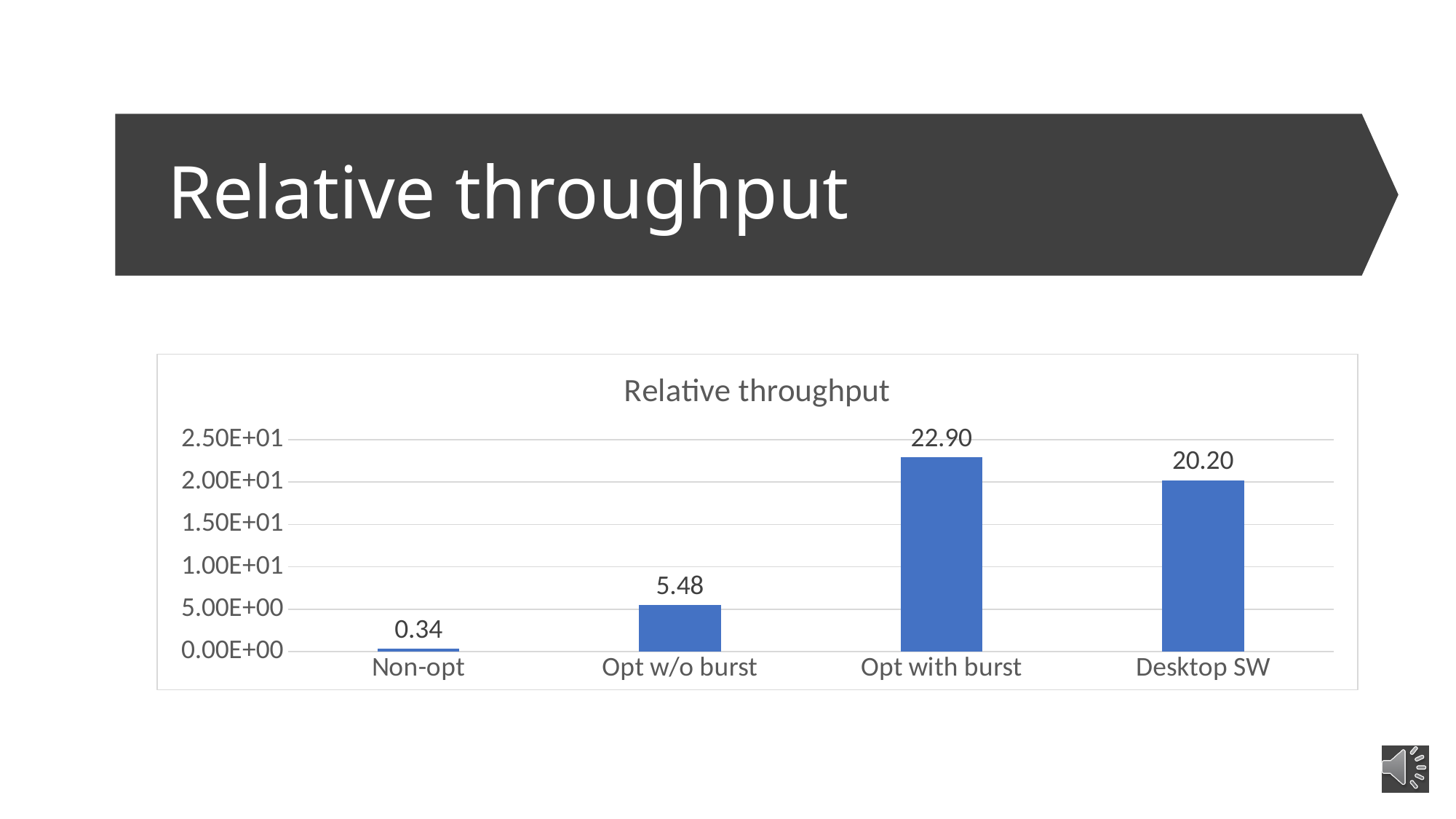
What is the relative throughput value for Non-opt? 0.34 Which category has the highest relative throughput? Opt with burst Which is larger, the value for Opt w/o burst or the value for Desktop SW? Desktop SW What is the relative throughput value for Desktop SW? 20.20 What is the title of the chart? Relative throughput What is the relative throughput value for Opt w/o burst? 5.48 How many categories are shown on the x axis? 4 What is the relative throughput value for Opt with burst? 22.90 What kind of chart is shown on the slide? Bar chart What is the difference between the values for Opt with burst and Desktop SW? 2.70 What is the difference between the values for Opt w/o burst and Non-opt? 5.14 Which category has the lowest relative throughput? Non-opt